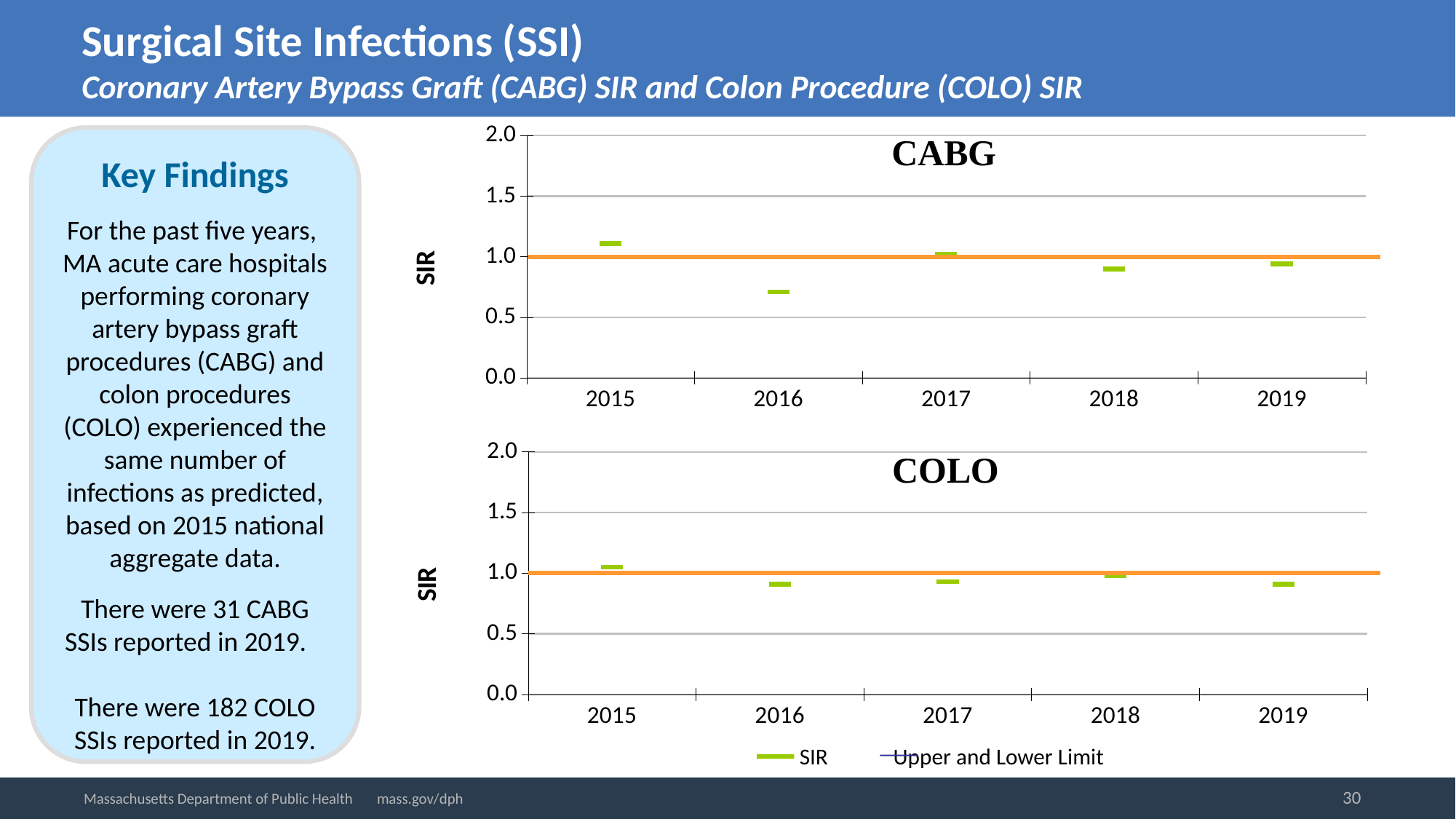
In the CABG chart, is the SIR value for 2015 greater or less than 1.0? greater In the CABG chart, which year has the lowest SIR? 2016 How many years are shown on the x axis of the COLO chart? 5 In the CABG chart, is the SIR value for 2016 greater or less than 0.5? greater In the CABG chart, which year has the larger SIR, 2015 or 2016? 2015 In the COLO chart, is the SIR value for 2016 greater or less than 1.0? less How many series does the legend below the COLO chart list? 2 In the CABG chart, which year has the highest SIR? 2015 What is the label on the y axis of the CABG chart? SIR In the COLO chart, which year has the highest SIR? 2015 What are the two entries in the legend below the charts? SIR; Upper and Lower Limit